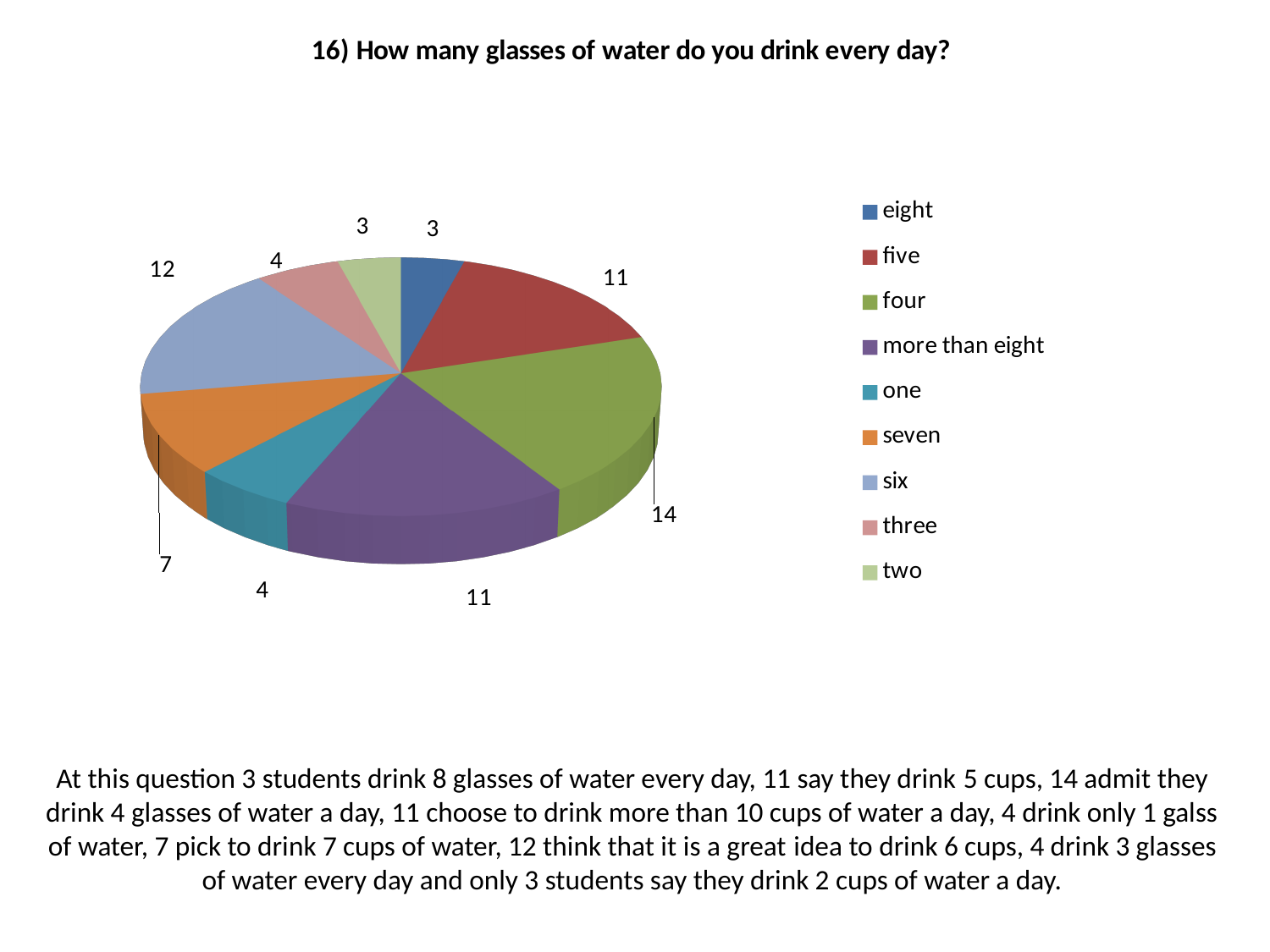
Which category has the largest slice of the pie? four Which categories have the smallest value in the chart? eight and two What is the value for the 'more than eight' slice? 11 What is the value for the 'six' slice? 12 What type of chart is shown on the slide? pie chart What is the title of the chart? 16) How many glasses of water do you drink every day? How many categories are shown in the pie chart? 9 What is the value for the 'seven' slice? 7 Which is larger, the value for 'seven' or the value for 'three'? seven What is the difference between the values for 'four' and 'six'? 2 How many students drink four glasses of water a day according to the chart? 14 What is the difference between the values for 'five' and 'one'? 7